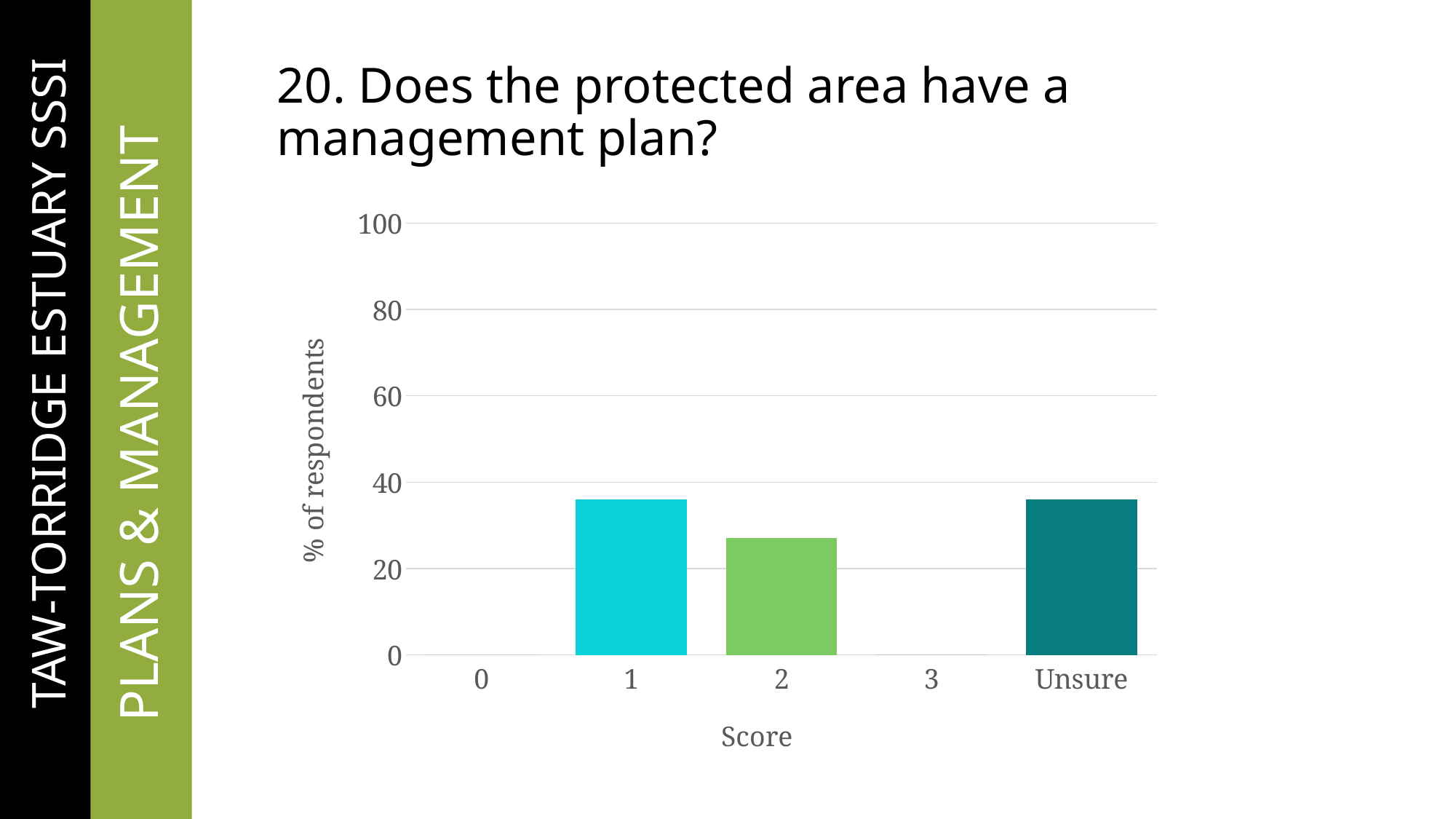
Which has the larger value, Unsure or score 2? Unsure Is the value for score 1 greater or less than 20? greater Is the value for Unsure greater or less than 40? less How many score categories are shown on the x axis of the chart? 5 How many of the score categories have a visible bar in the chart? 3 What is the label of the horizontal axis of the chart? Score Which has the larger value, score 1 or score 2? score 1 What kind of chart is shown on the slide? bar chart What is the label of the vertical axis of the chart? % of respondents Is the value for score 1 greater or less than 40? less